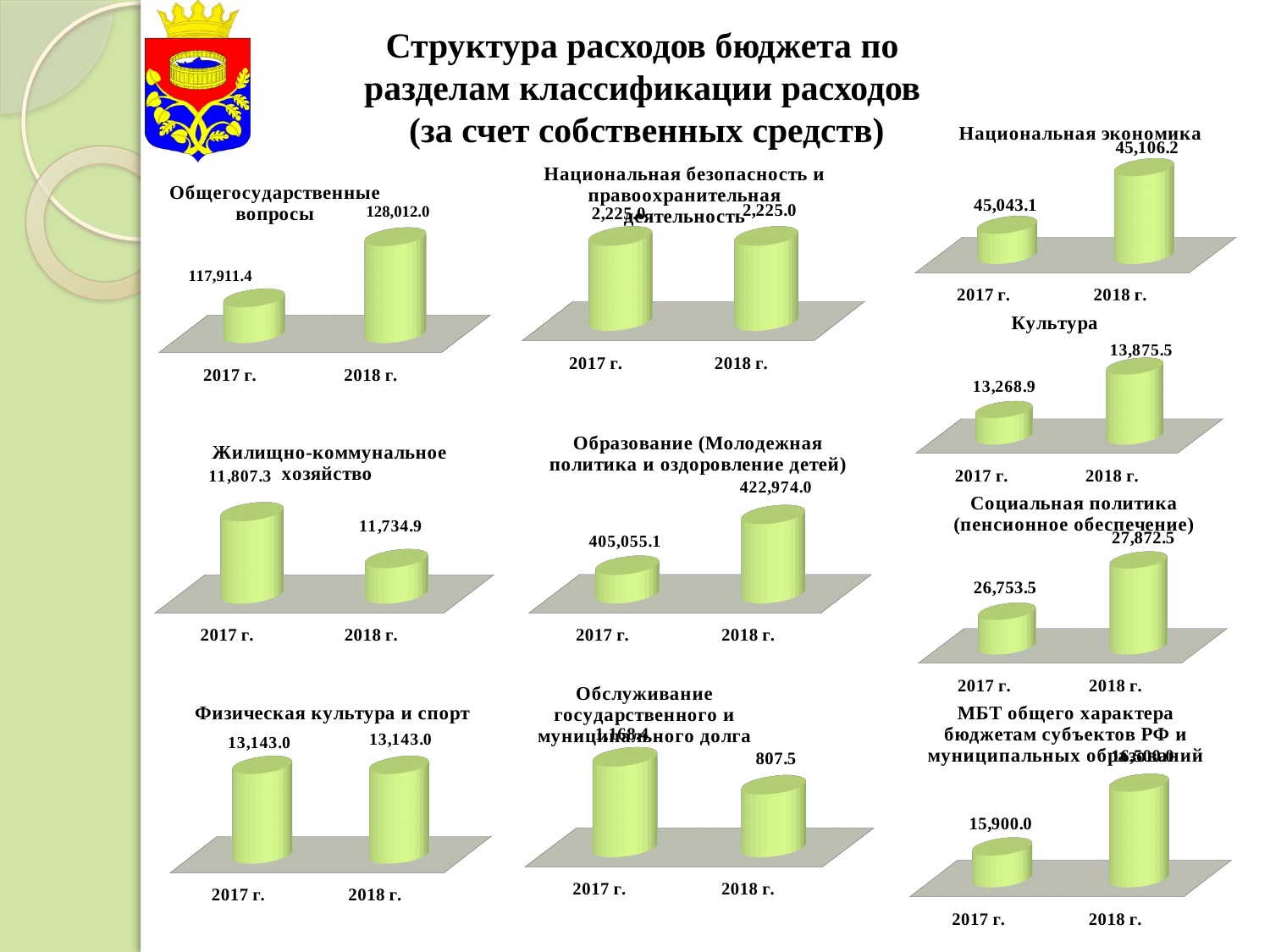
In the 'Образование (Молодежная политика и оздоровление детей)' chart, what is the difference between the 2018 г. and 2017 г. values? 17,918.9 In the 'Национальная экономика' chart, what is the value for 2018 г.? 45,106.2 In the 'Обслуживание государственного и муниципального долга' chart, do the values rise or fall from 2017 г. to 2018 г.? fall In the 'Жилищно-коммунальное хозяйство' chart, which year has the higher value, 2017 г. or 2018 г.? 2017 г. In the 'Общегосударственные вопросы' chart, what is the value for 2017 г.? 117,911.4 In the 'Культура' chart, what is the value for 2018 г.? 13,875.5 In the 'Физическая культура и спорт' chart, what is the value for 2017 г.? 13,143.0 What kind of chart is the 'Национальная экономика' chart? bar chart In the 'Обслуживание государственного и муниципального долга' chart, what is the value for 2018 г.? 807.5 In the 'Социальная политика (пенсионное обеспечение)' chart, what is the value for 2017 г.? 26,753.5 In the 'Общегосударственные вопросы' chart, what is the value for 2018 г.? 128,012.0 How many categories (years) does the 'Культура' chart show? 2